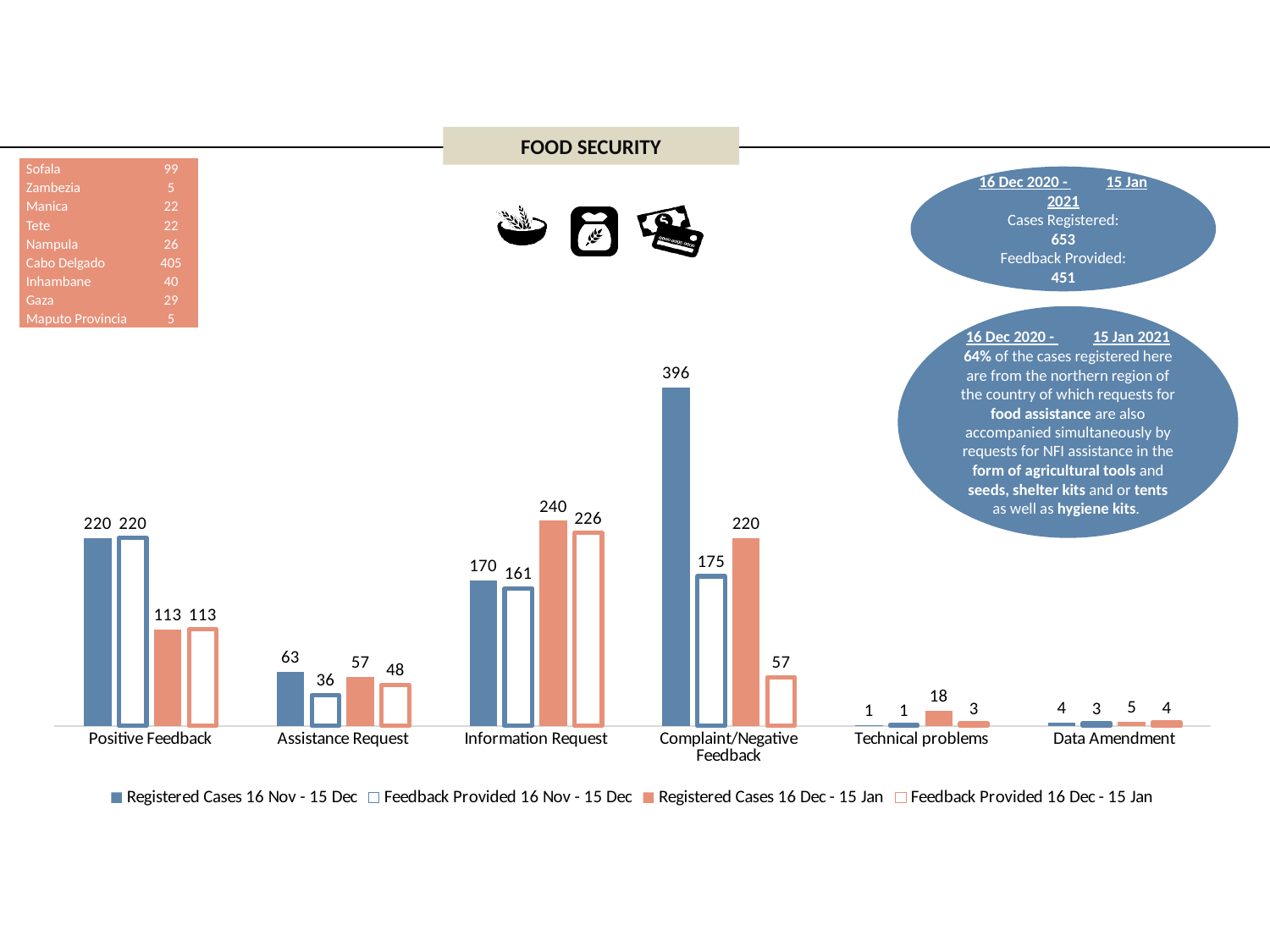
What is the difference between Registered Cases 16 Dec - 15 Jan and Feedback Provided 16 Dec - 15 Jan for Positive Feedback? 0 Which category has the lowest value for Registered Cases 16 Nov - 15 Dec? Technical problems What is the value of Registered Cases 16 Dec - 15 Jan for Technical problems? 18 How many categories are shown on the x axis of the chart? 6 What is the difference between Registered Cases 16 Nov - 15 Dec and Feedback Provided 16 Nov - 15 Dec for Complaint/Negative Feedback? 221 How many series does the chart legend list? 4 What kind of chart is shown on the slide? Bar chart What is the value of Feedback Provided 16 Dec - 15 Jan for Information Request? 226 What is the title shown above the chart on the slide? FOOD SECURITY For Assistance Request, which is larger: Registered Cases 16 Nov - 15 Dec or Registered Cases 16 Dec - 15 Jan? Registered Cases 16 Nov - 15 Dec Which category has the highest value for Registered Cases 16 Dec - 15 Jan? Information Request What is the value of Registered Cases 16 Nov - 15 Dec for Complaint/Negative Feedback? 396